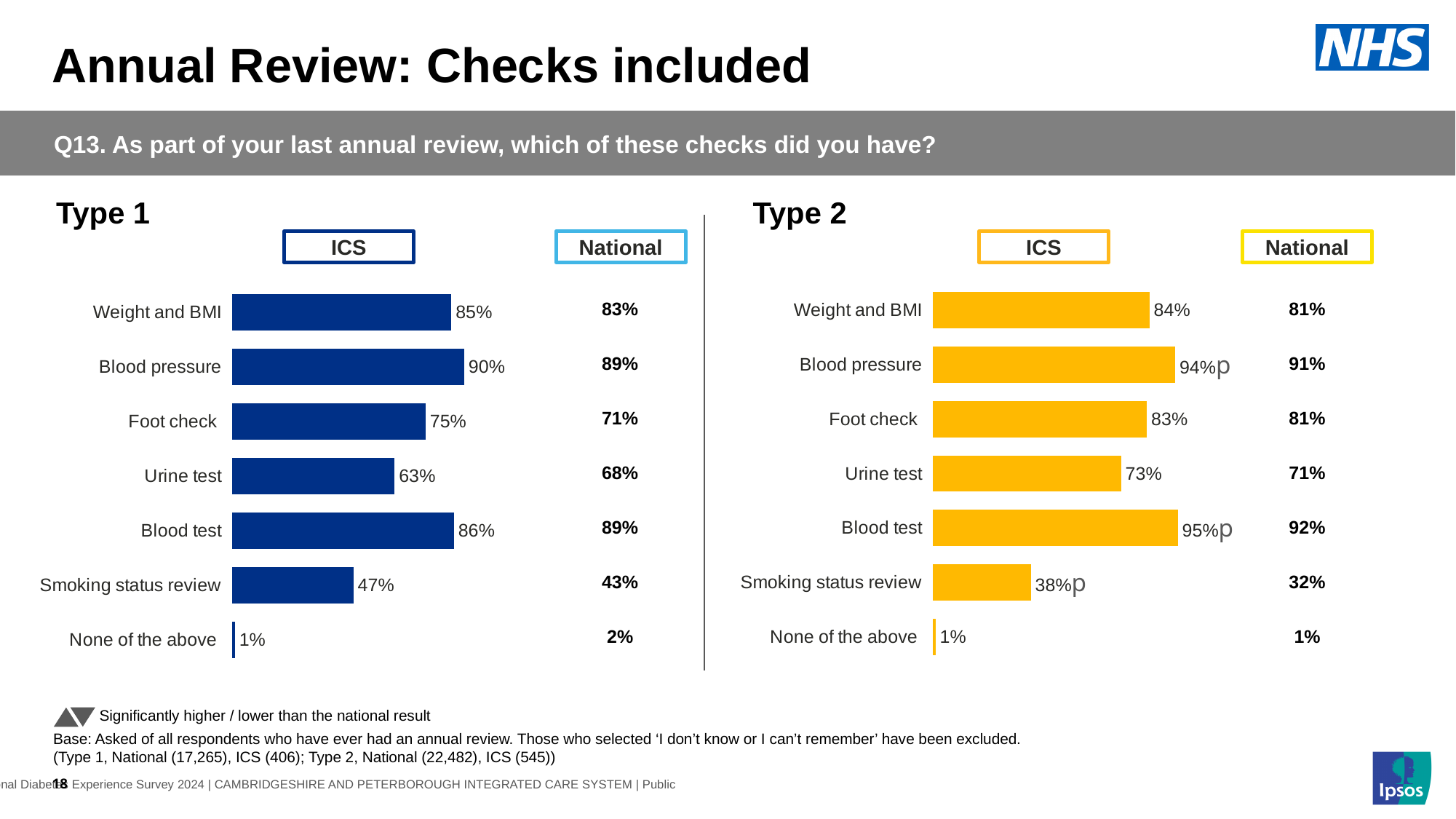
In the Type 1 chart, what is the ICS value for Foot check? 75% In the Type 1 chart, what is the difference between the ICS values for Blood test and Urine test? 23% In the Type 2 chart, which is larger for Foot check: the ICS value or the National value? ICS In the Type 1 chart, what is the National value for Urine test? 68% How many checks are listed in the Type 1 chart? 7 In the Type 2 chart, what is the National value for Blood test? 92% In the Type 2 chart, what is the ICS value for Smoking status review? 38% In the Type 1 chart, which is larger for Blood test: the ICS value or the National value? National In the Type 2 chart, which check has the lowest ICS value? None of the above In the Type 2 chart, what is the difference between the ICS and National values for Smoking status review? 6% In the Type 1 chart, which check has the highest ICS value? Blood pressure What type of chart is used for the Type 2 ICS results? Bar chart